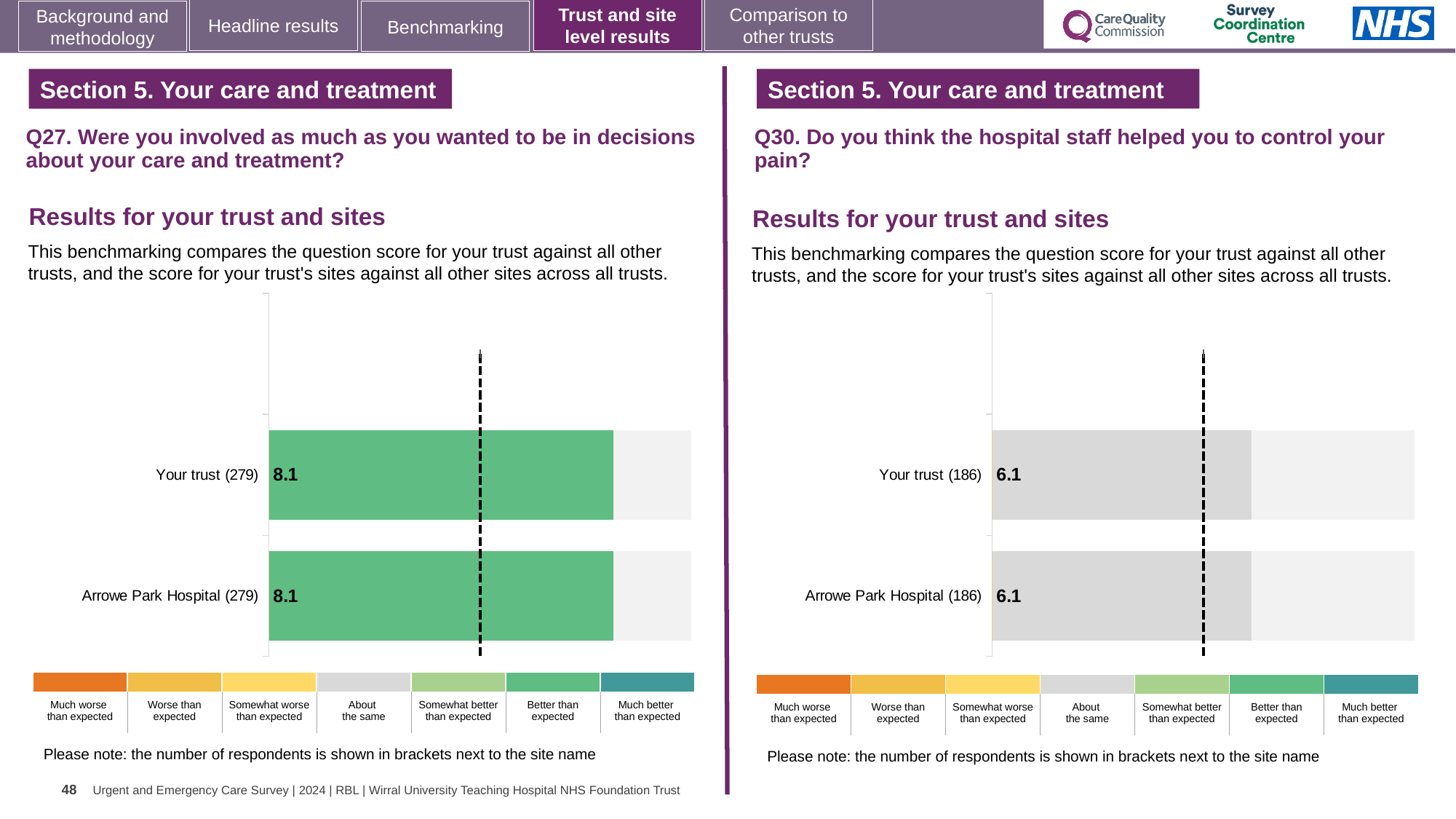
On the Q27 chart (left), what is the difference between the Your trust score and the Arrowe Park Hospital score? 0 On the Q30 chart (right), what is the score for Your trust? 6.1 How many bars are plotted on the Q27 chart (left)? 2 On the Q27 chart (left), what is the score for Arrowe Park Hospital? 8.1 On the Q30 chart (right), how many respondents are shown in brackets for Arrowe Park Hospital? 186 How many bars are plotted on the Q30 chart (right)? 2 On the Q27 chart (left), how many respondents are shown in brackets for Your trust? 279 On the Q27 chart (left), what is the score for Your trust? 8.1 What type of chart is used on the Q27 chart (left)? Bar chart On the Q30 chart (right), what is the score for Arrowe Park Hospital? 6.1 On the Q30 chart (right), what is the difference between the Your trust score and the Arrowe Park Hospital score? 0 Is the Your trust score on the Q27 chart (left) larger or smaller than the Your trust score on the Q30 chart (right)? Larger